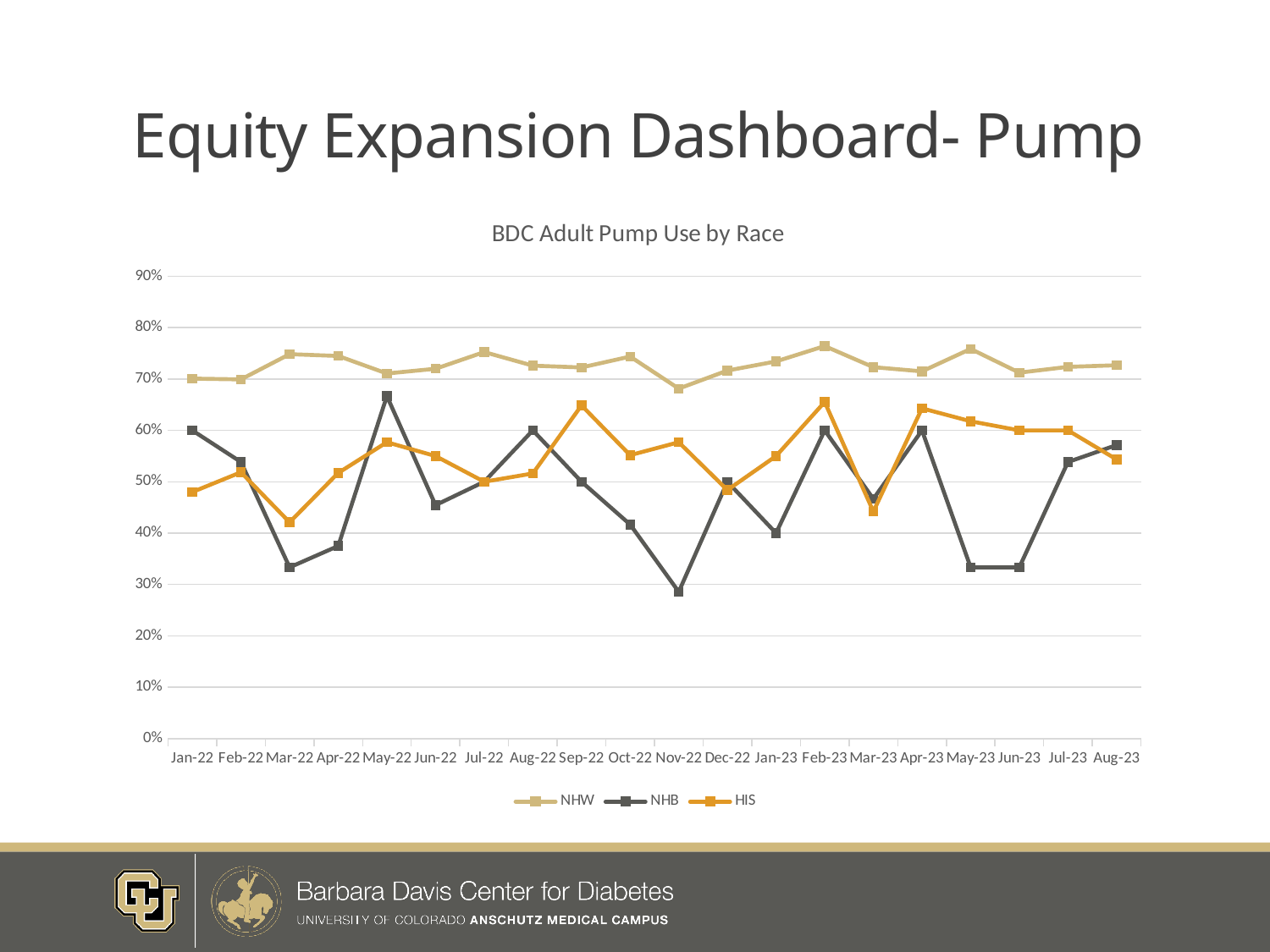
Is the NHW value for Feb-23 greater or less than 70%? greater How many series does the legend list? 3 Which series is shown in orange in the legend? HIS What kind of chart is shown on the slide? line chart What is the title of the chart? BDC Adult Pump Use by Race What is the NHB value for Jan-22? 60% How many months are plotted along the x axis? 20 In which month is the NHB series at its highest? May-22 Is the NHB value for Nov-22 greater or less than 40%? less In Nov-22, which is larger, the NHB value or the HIS value? HIS In which month is the NHB series at its lowest? Nov-22